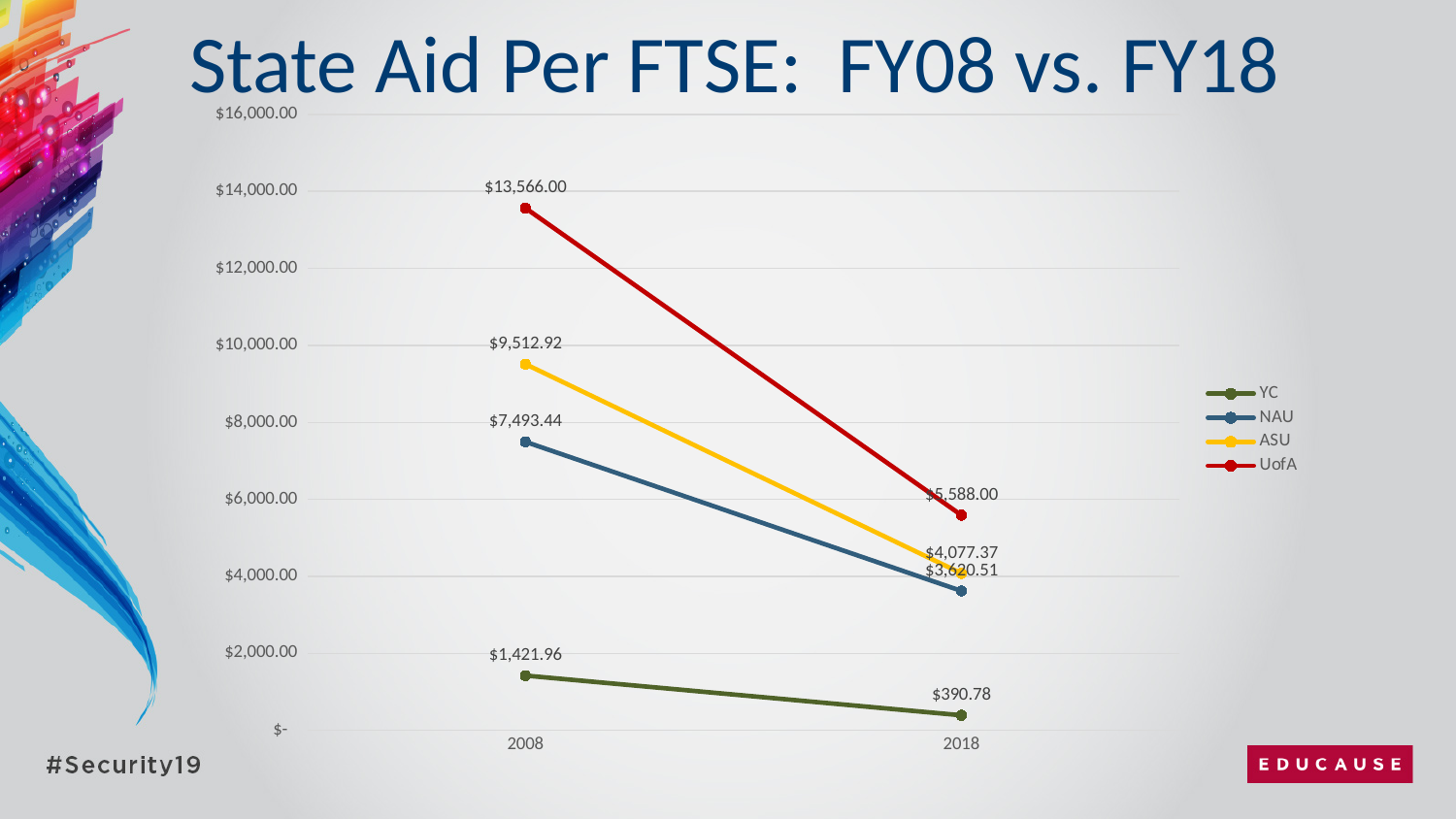
Which was larger in 2018, the value for ASU or the value for NAU? ASU Which institution had the highest state aid per FTSE in 2008? UofA What kind of chart is shown on the slide? line chart What was the state aid per FTSE for NAU in 2018? $3,620.51 Do the values for all institutions rise or fall from 2008 to 2018? fall What colour is the line for UofA? red By how much did UofA's state aid per FTSE fall from 2008 to 2018? $7,978.00 What was the state aid per FTSE for YC in 2018? $390.78 What was the state aid per FTSE for UofA in 2008? $13,566.00 What was the state aid per FTSE for ASU in 2008? $9,512.92 How many series does the legend list? 4 Which institution had the lowest state aid per FTSE in 2018? YC